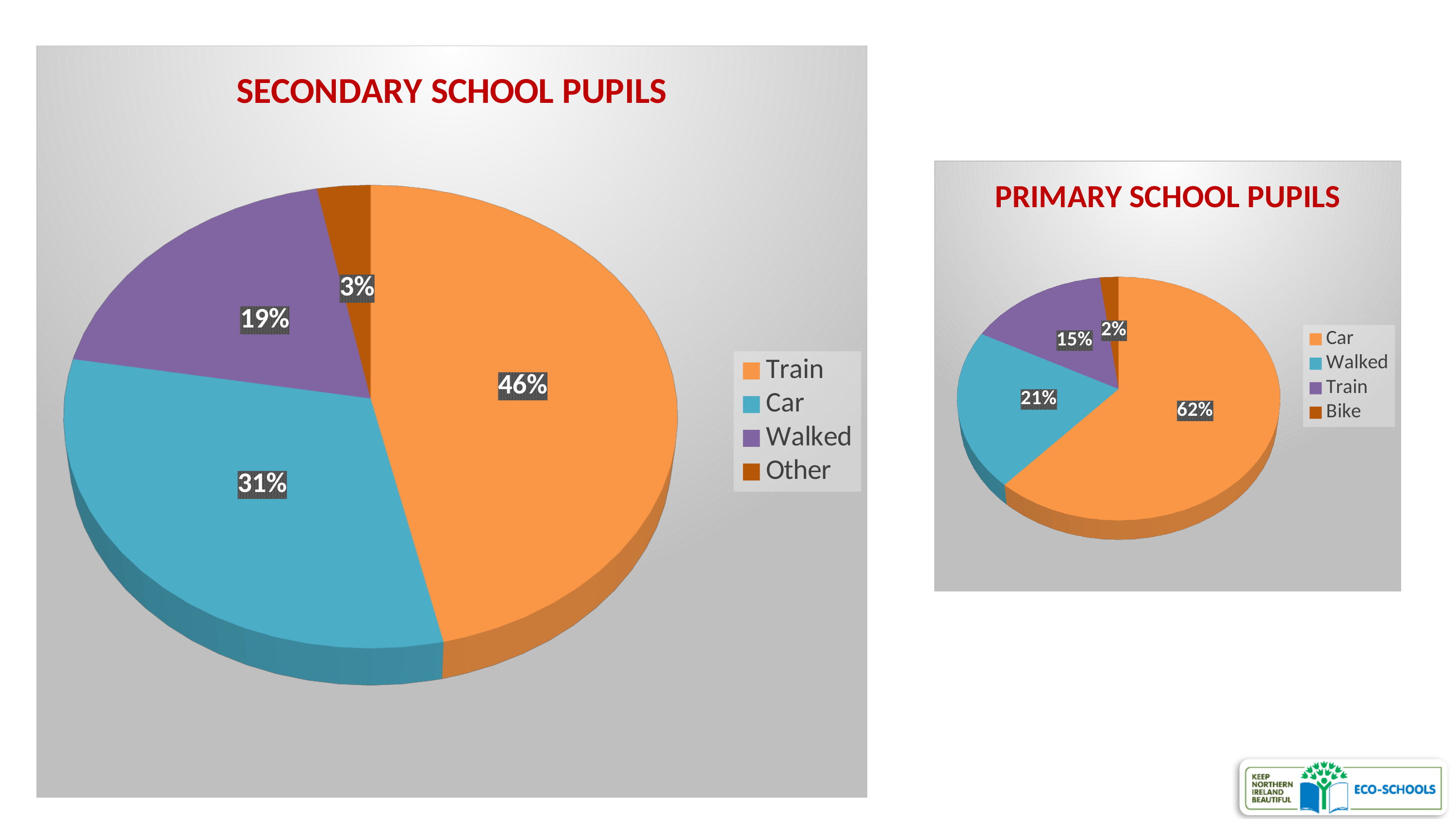
In the 'SECONDARY SCHOOL PUPILS' chart, which is larger, the share for Car or the share for Walked? Car In the 'SECONDARY SCHOOL PUPILS' chart, which mode of travel has the largest share? Train What kind of chart is the 'SECONDARY SCHOOL PUPILS' chart? Pie chart In the 'PRIMARY SCHOOL PUPILS' chart, which mode of travel has the smallest share? Bike In the 'PRIMARY SCHOOL PUPILS' chart, what percentage of pupils travel by bike? 2% In the 'PRIMARY SCHOOL PUPILS' chart, what percentage of pupils travel by car? 62% How many categories does the 'PRIMARY SCHOOL PUPILS' chart show? 4 In the 'SECONDARY SCHOOL PUPILS' chart, what percentage of pupils travel by train? 46% In the 'PRIMARY SCHOOL PUPILS' chart, what colour is the Walked slice? Blue In the 'SECONDARY SCHOOL PUPILS' chart, what is the difference in percentage points between Train and Car? 15 In the 'SECONDARY SCHOOL PUPILS' chart, what percentage of pupils walked? 19% In the 'PRIMARY SCHOOL PUPILS' chart, what is the difference in percentage points between Walked and Train? 6